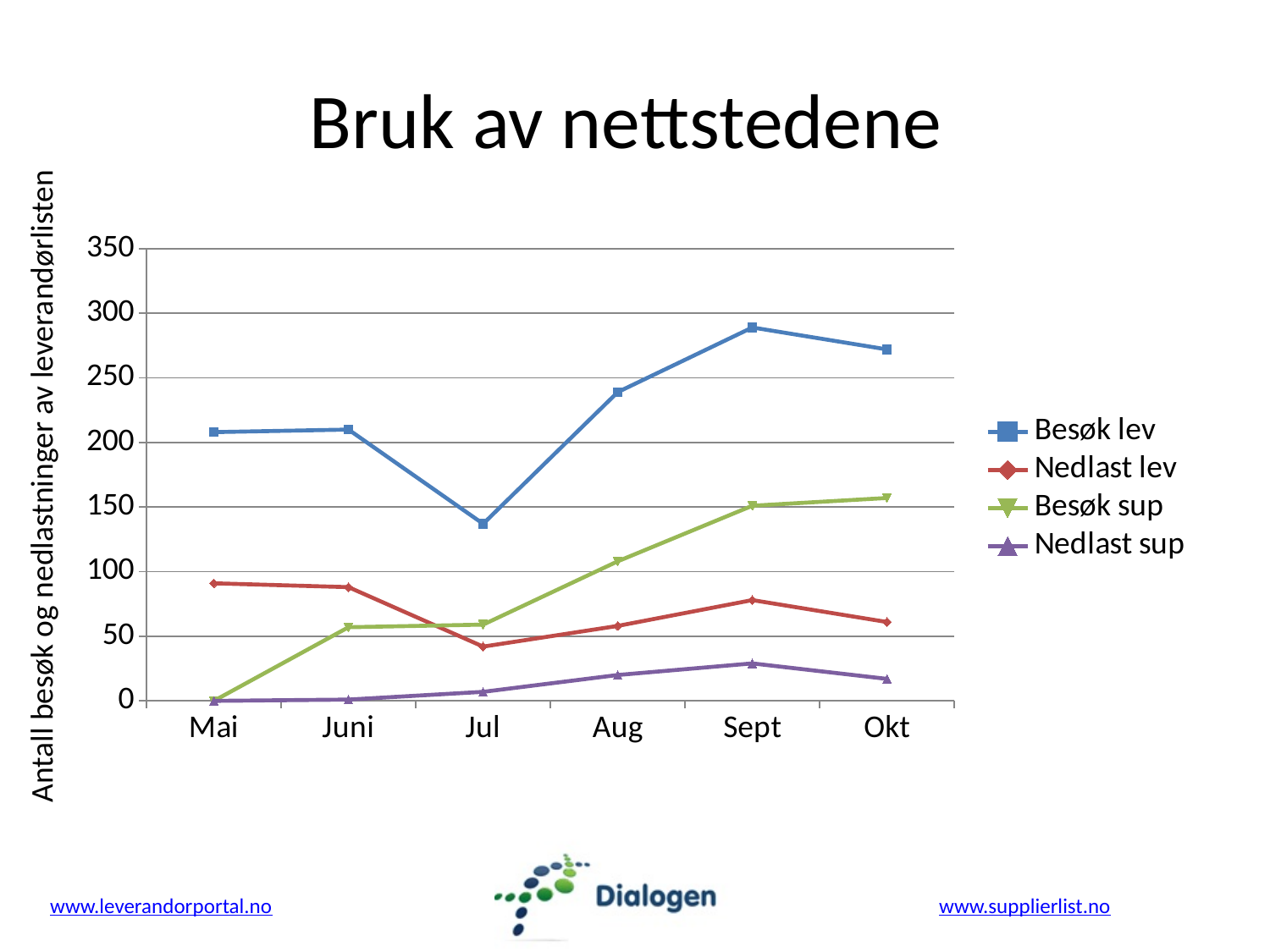
What kind of chart is shown on the slide? Line chart What is the title of the chart? Bruk av nettstedene Is the value for Besøk lev in Jul greater or less than 150? less How many series does the legend list? 4 In which month does the Besøk lev series reach its lowest value? Jul In which month does the Besøk lev series reach its highest value? Sept Is the value for Besøk sup in Sept greater or less than 100? greater How many months are shown on the x axis? 6 Is the value for Besøk lev in Sept greater or less than 250? greater In Aug, which is larger: Besøk sup or Nedlast lev? Besøk sup Does the Besøk sup series generally rise or fall from Mai to Okt? Rise In Mai, which is larger: Nedlast lev or Besøk sup? Nedlast lev